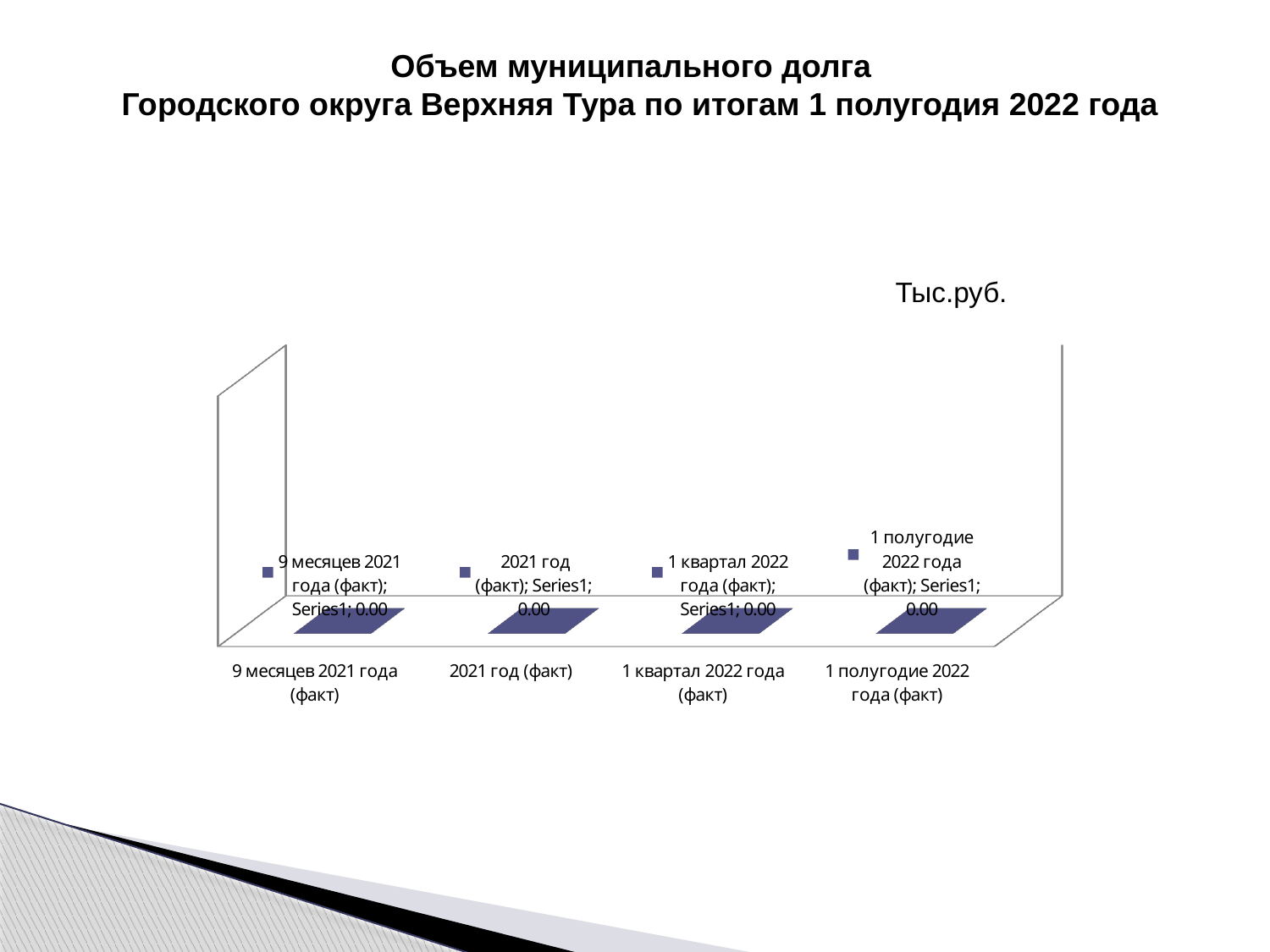
What is the value for "2021 год (факт)"? 0.00 What is the name of the data series shown in the data labels? Series1 What is the label of the last (rightmost) category on the x axis? 1 полугодие 2022 года (факт) What is the difference between the values for "2021 год (факт)" and "1 полугодие 2022 года (факт)"? 0.00 How many categories are shown on the x axis of the chart? 4 Do the values rise, fall, or stay the same across the categories from left to right? Stay the same What is the value for "9 месяцев 2021 года (факт)"? 0.00 What is the value for "1 полугодие 2022 года (факт)"? 0.00 What kind of chart is shown on the slide? Bar chart What is the value for "1 квартал 2022 года (факт)"? 0.00 What unit of measurement is indicated for the chart? Тыс.руб.